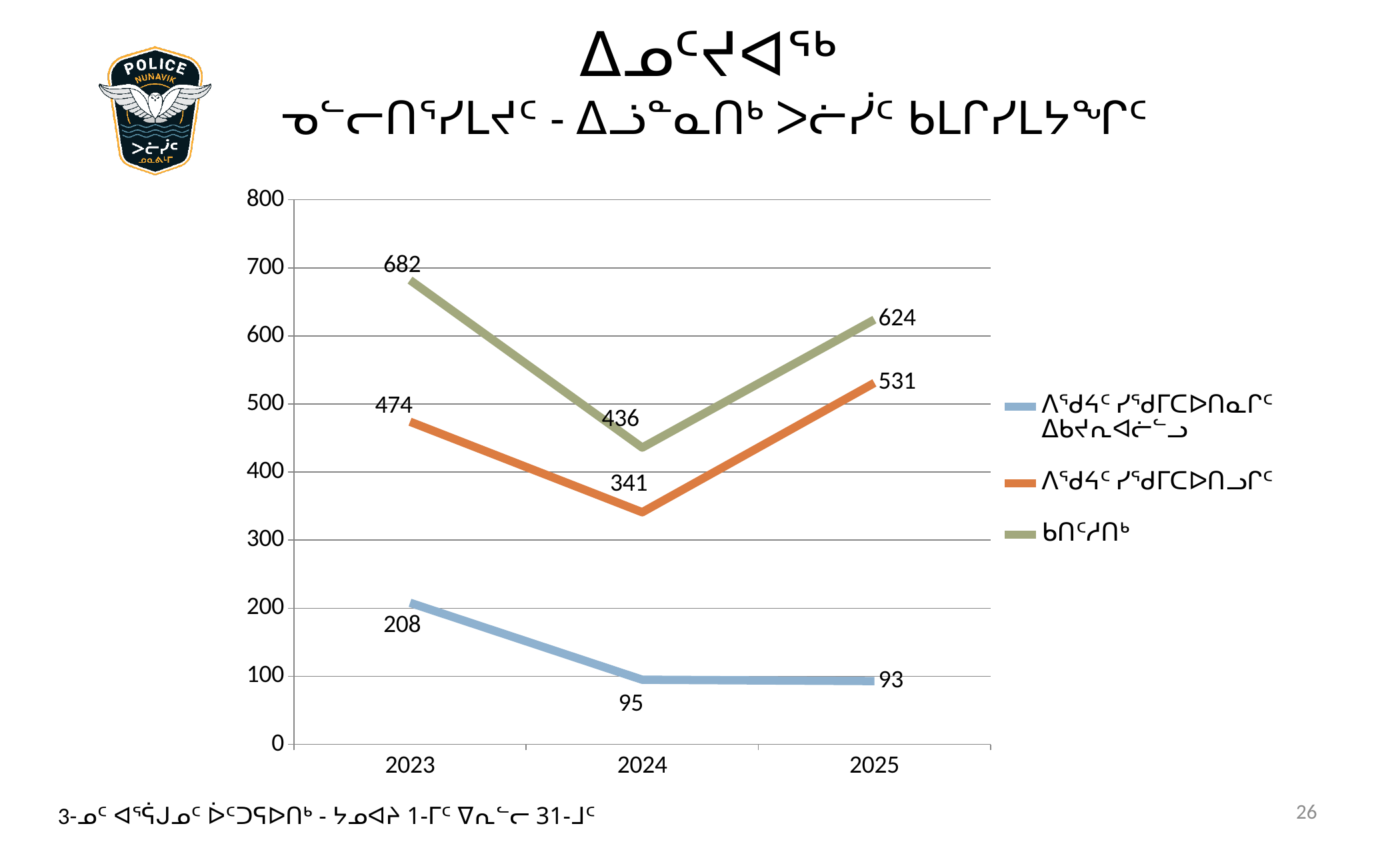
What is the value of the blue line in 2025? 93 What is the value of the green line in 2023? 682 Which is larger in 2025: the green line or the orange line? the green line In which year is the orange line at its highest? 2025 Is the value of the orange line in 2023 greater or less than 400? greater Does the blue line rise or fall from 2023 to 2024? fall How many years are shown on the x axis? 3 In which year is the green line at its lowest? 2024 What is the difference between the green line's 2023 value and its 2024 value? 246 How many series does the legend list? 3 What is the value of the orange line in 2024? 341 What kind of chart is shown on the slide? line chart